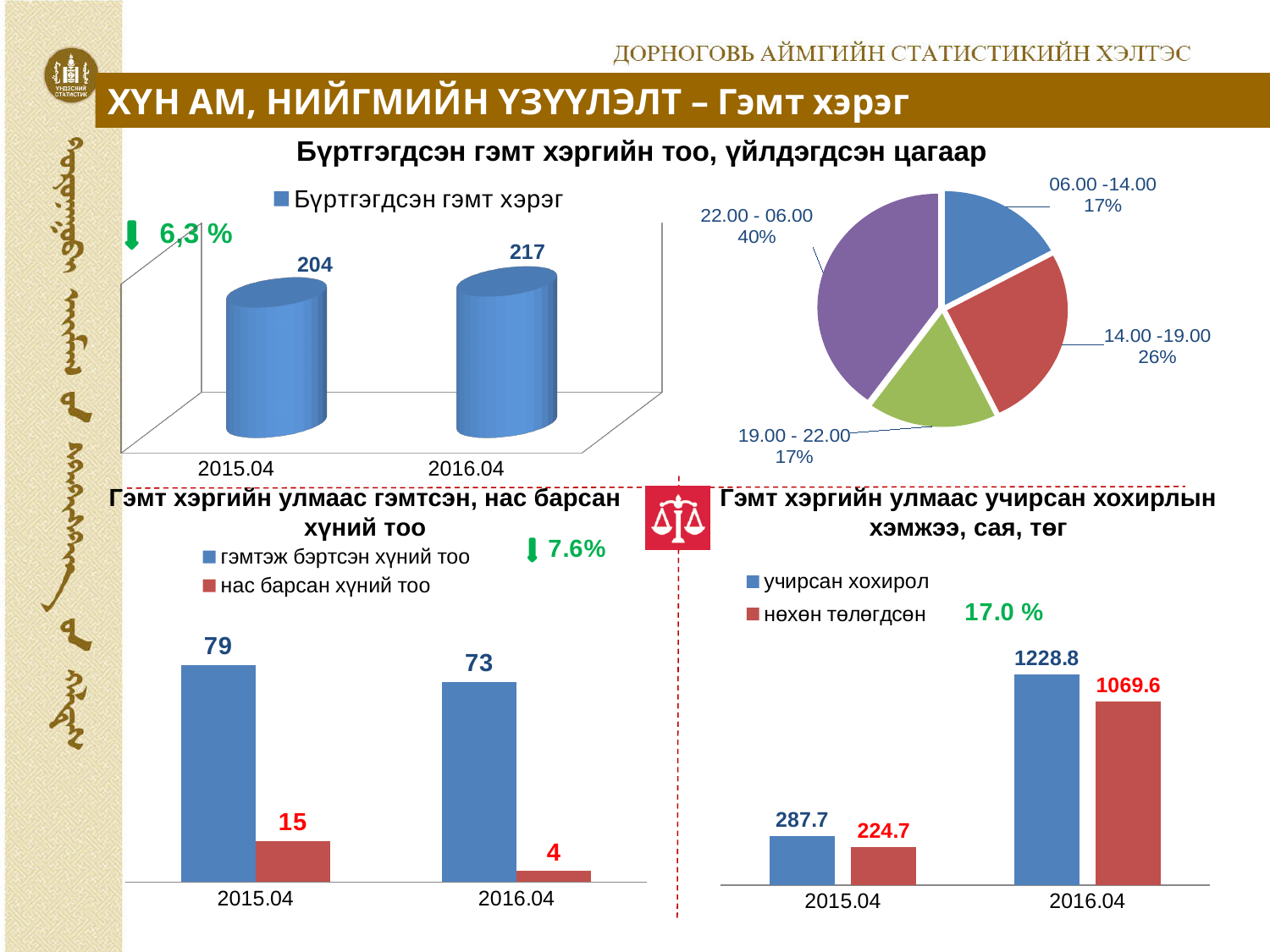
In the bottom-left bar chart (Гэмт хэргийн улмаас гэмтсэн, нас барсан хүний тоо), what is the difference in гэмтэж бэртсэн хүний тоо between 2015.04 and 2016.04? 6 In the bottom-right bar chart (Гэмт хэргийн улмаас учирсан хохирлын хэмжээ, сая, төг), which is larger for 2015.04: учирсан хохирол or нөхөн төлөгдсөн? учирсан хохирол In the bottom-left bar chart (Гэмт хэргийн улмаас гэмтсэн, нас барсан хүний тоо), what is the value of нас барсан хүний тоо for 2016.04? 4 In the top-left bar chart (Бүртгэгдсэн гэмт хэрэг), what is the value for 2015.04? 204 In the top-right pie chart, what share does the 14.00 -19.00 slice have? 26% In the bottom-right bar chart (Гэмт хэргийн улмаас учирсан хохирлын хэмжээ, сая, төг), what is the value of учирсан хохирол for 2016.04? 1228.8 How many series does the legend of the bottom-left bar chart list? 2 In the top-left bar chart (Бүртгэгдсэн гэмт хэрэг), what is the difference between the 2016.04 and 2015.04 values? 13 In the top-left bar chart (Бүртгэгдсэн гэмт хэрэг), what is the value for 2016.04? 217 How many slices does the top-right pie chart have? 4 What type of chart is the top-right chart showing crimes by time of day? Pie chart In the top-right pie chart, which time period has the largest share? 22.00 - 06.00